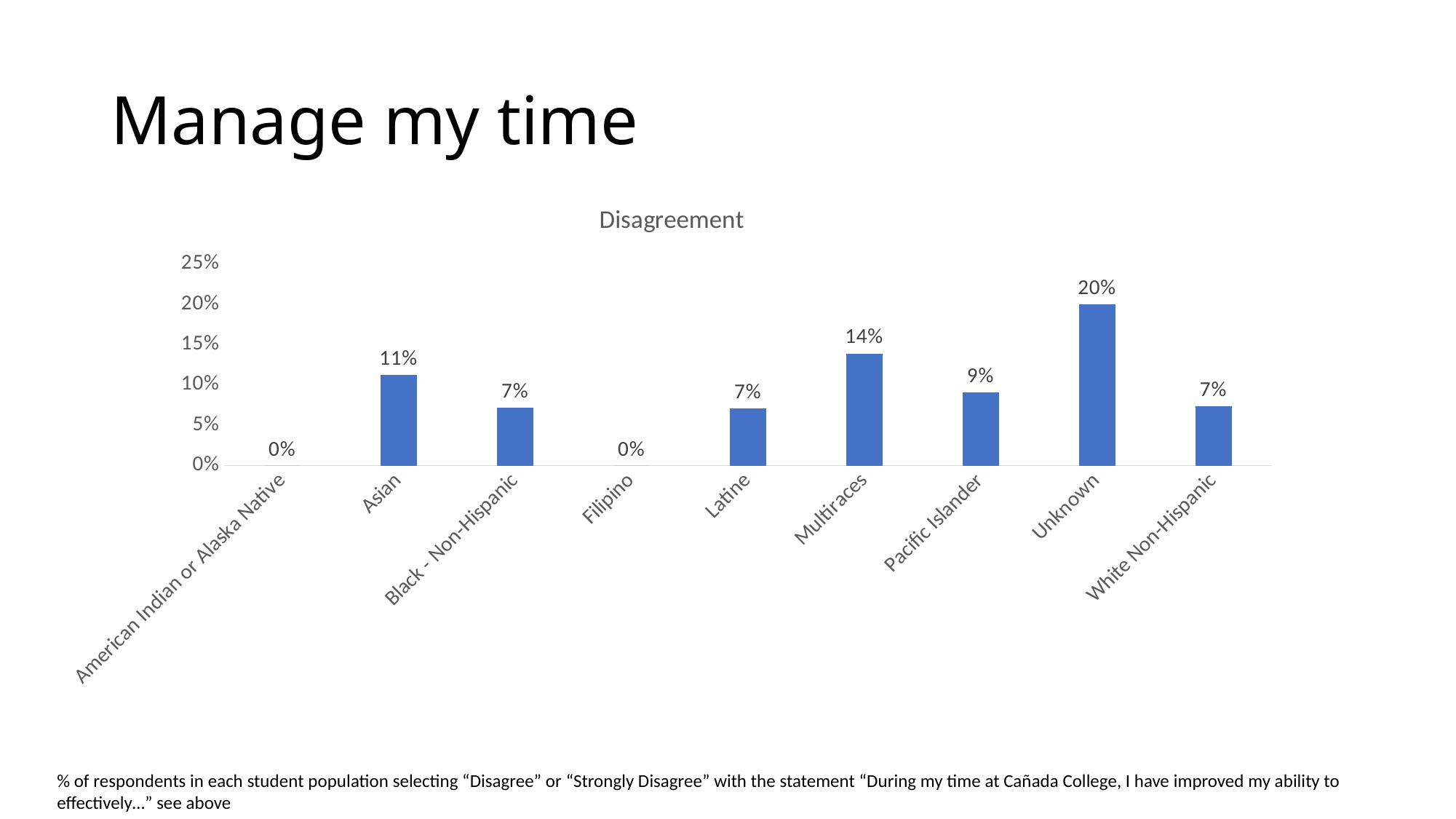
What is the title of the chart? Disagreement How many categories are shown on the x axis? 9 What kind of chart is shown on the slide? Bar chart How many categories have a disagreement value of 0%? 2 What is the disagreement value for Asian? 11% Which is larger, the disagreement value for Multiraces or for Asian? Multiraces What is the disagreement value for Pacific Islander? 9% What is the difference between the disagreement values for Asian and Pacific Islander? 2% What is the disagreement value for Unknown? 20% What is the disagreement value for Multiraces? 14% Which category has the highest disagreement value? Unknown What is the difference between the disagreement values for Unknown and Multiraces? 6%